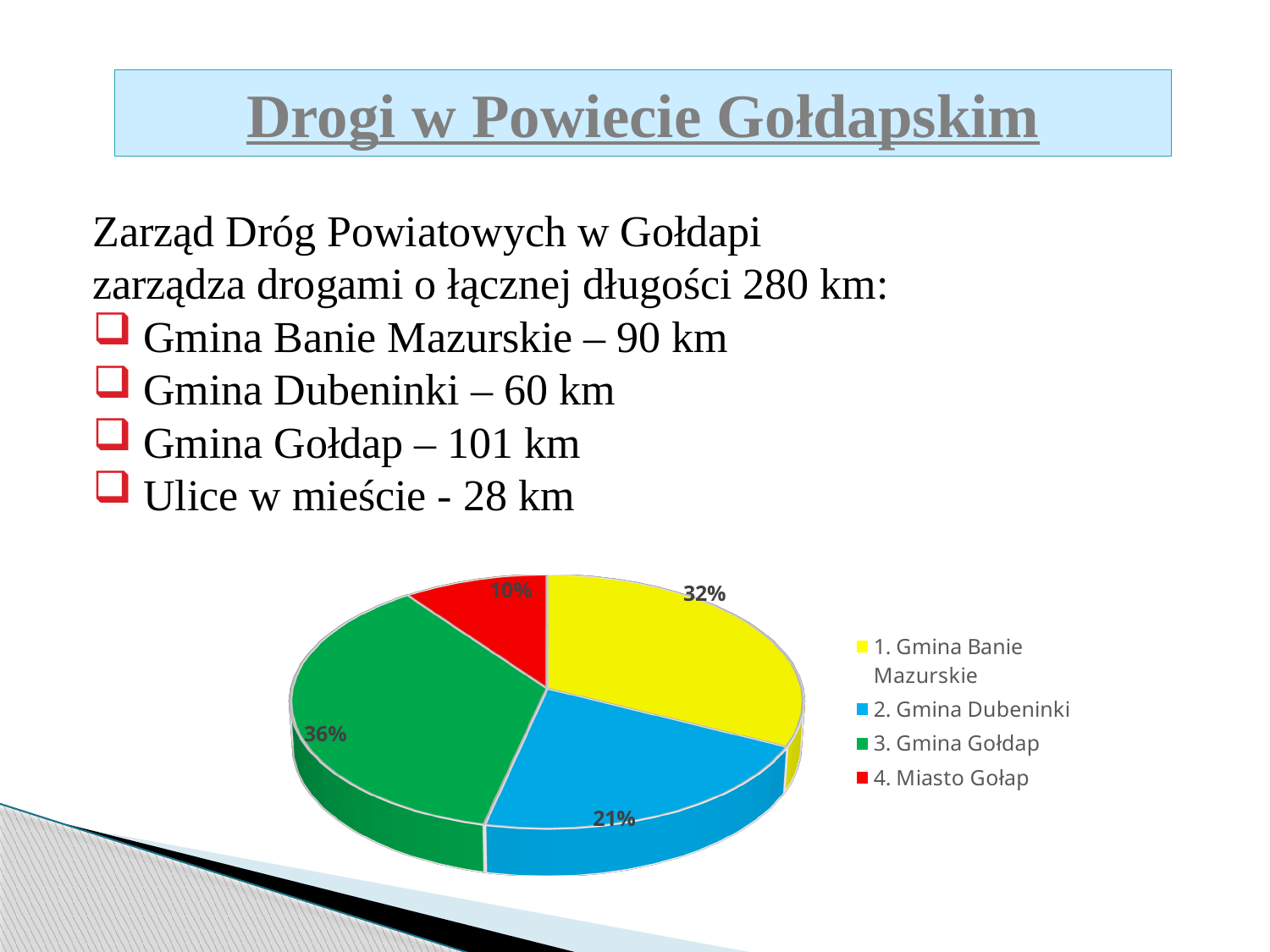
How many entries does the chart legend list? 4 Which category has the largest slice of the pie? 3. Gmina Gołdap What percentage share does the slice for 2. Gmina Dubeninki have? 21% What is the difference in percentage points between the slices for 3. Gmina Gołdap and 2. Gmina Dubeninki? 15 What percentage share does the slice for 3. Gmina Gołdap have? 36% What colour is the slice for 2. Gmina Dubeninki? blue What kind of chart is shown on the slide? pie chart How many slices does the pie chart have? 4 What percentage share does the slice for 1. Gmina Banie Mazurskie have? 32% Which slice is larger: 1. Gmina Banie Mazurskie or 2. Gmina Dubeninki? 1. Gmina Banie Mazurskie What percentage share does the slice for 4. Miasto Gołap have? 10% Which category has the smallest slice of the pie? 4. Miasto Gołap